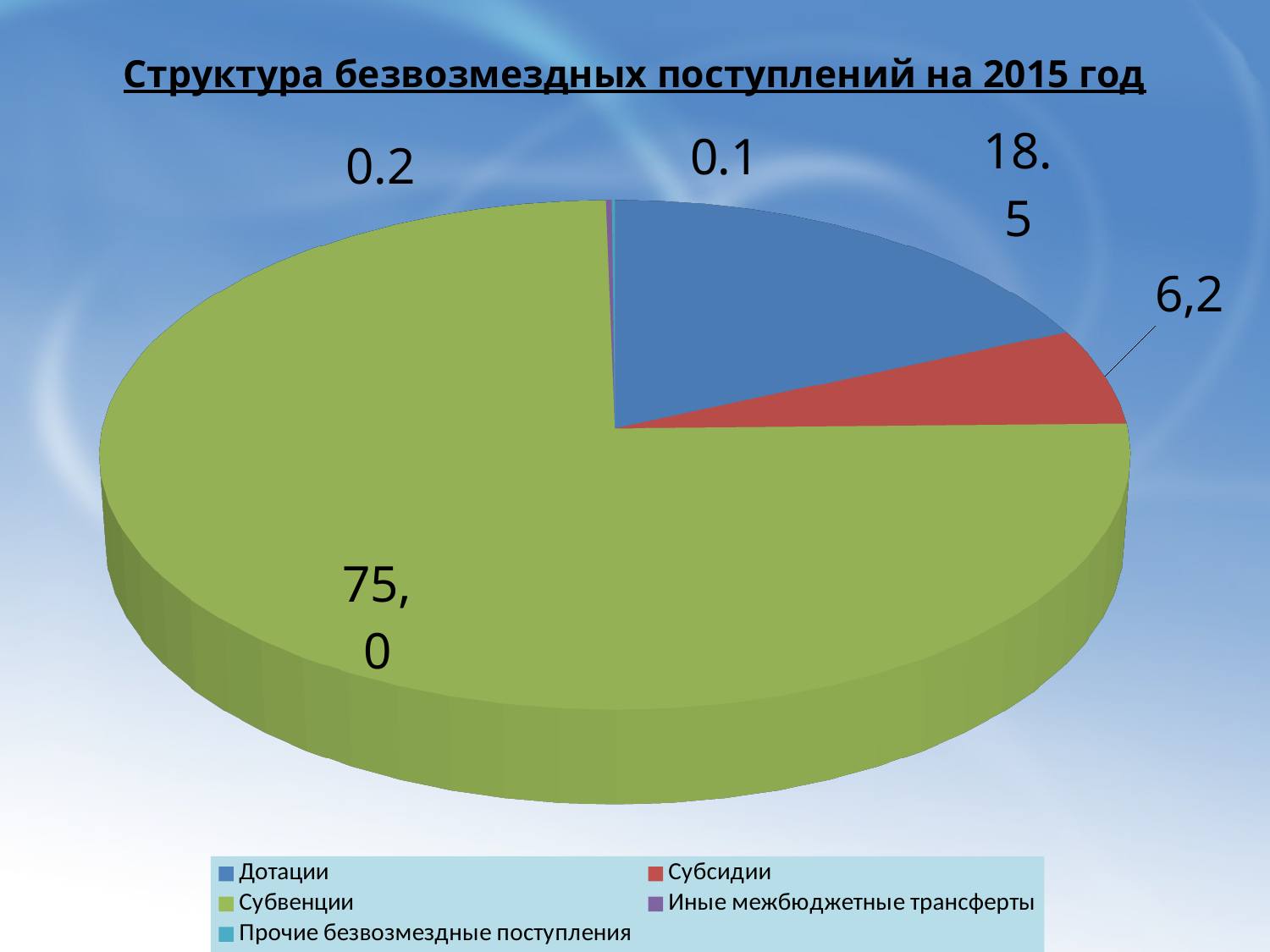
What is the value shown for Субсидии? 6,2 How many categories does the legend list? 5 What is the title of the chart? Структура безвозмездных поступлений на 2015 год What is the value shown for Субвенции? 75,0 What is the difference between the values for Дотации and Субсидии? 12.3 What is the value shown for Дотации? 18.5 What kind of chart is shown on the slide? pie chart Which category has the largest slice of the pie? Субвенции What is the difference between the values for Субвенции and Дотации? 56.5 Which is larger, the value for Субвенции or the value for Дотации? Субвенции Which is larger, the value for Дотации or the value for Субсидии? Дотации What colour is the slice for Субвенции? green